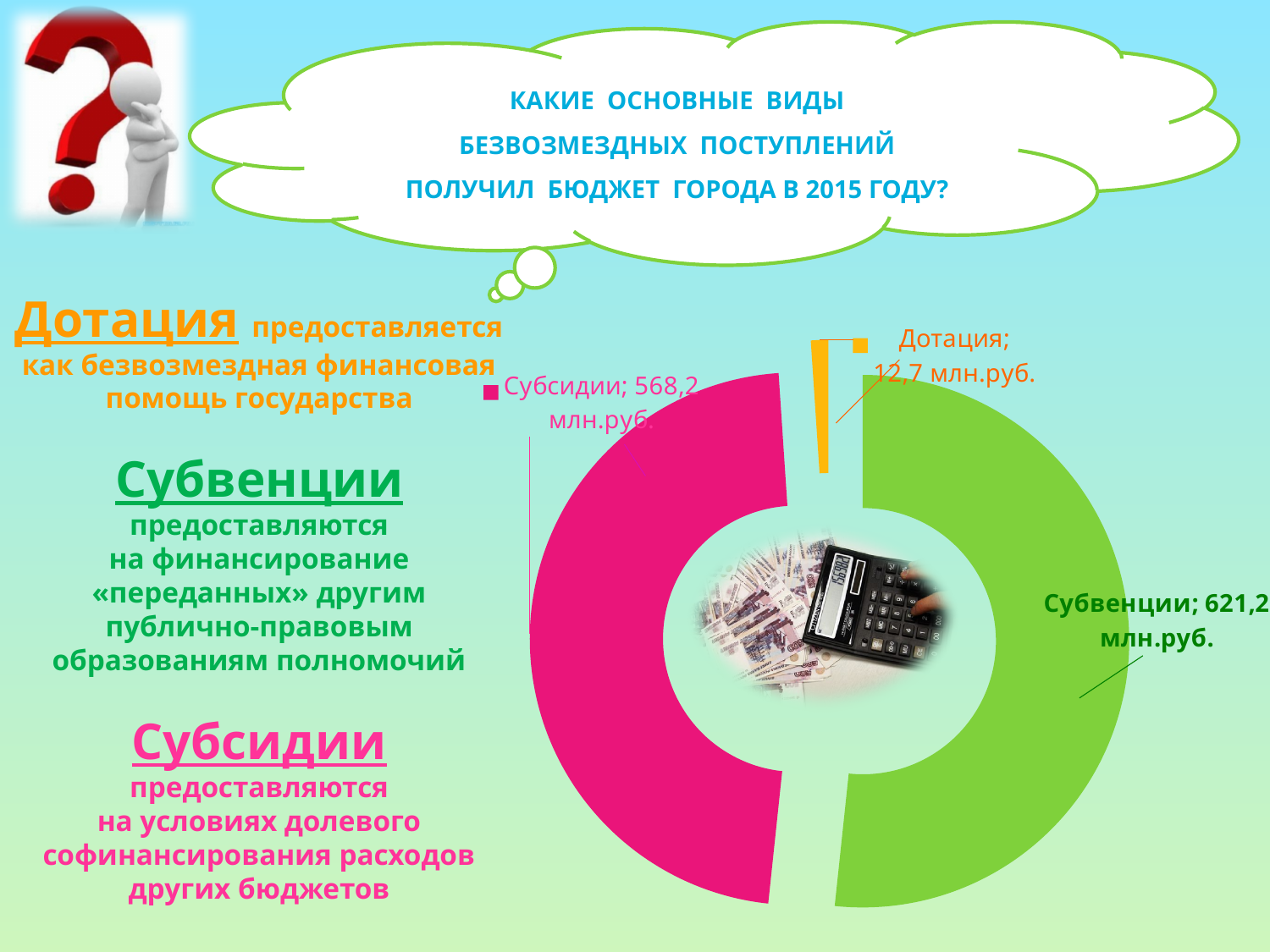
How many categories are shown in the chart? 3 What value is shown for Субсидии in the chart? 568,2 млн.руб. What is the difference between the values for Субсидии and Дотация? 555,5 млн.руб. Which is larger, the value for Дотация or the value for Субсидии? Субсидии What is the difference between the values for Субвенции and Субсидии? 53,0 млн.руб. What value is shown for Дотация in the chart? 12,7 млн.руб. What colour is the Субвенции slice in the chart? Green What value is shown for Субвенции in the chart? 621,2 млн.руб. Which category has the smallest value in the chart? Дотация Which is larger, the value for Субвенции or the value for Субсидии? Субвенции Which category has the largest value in the chart? Субвенции What kind of chart is shown on the slide? Pie (doughnut) chart